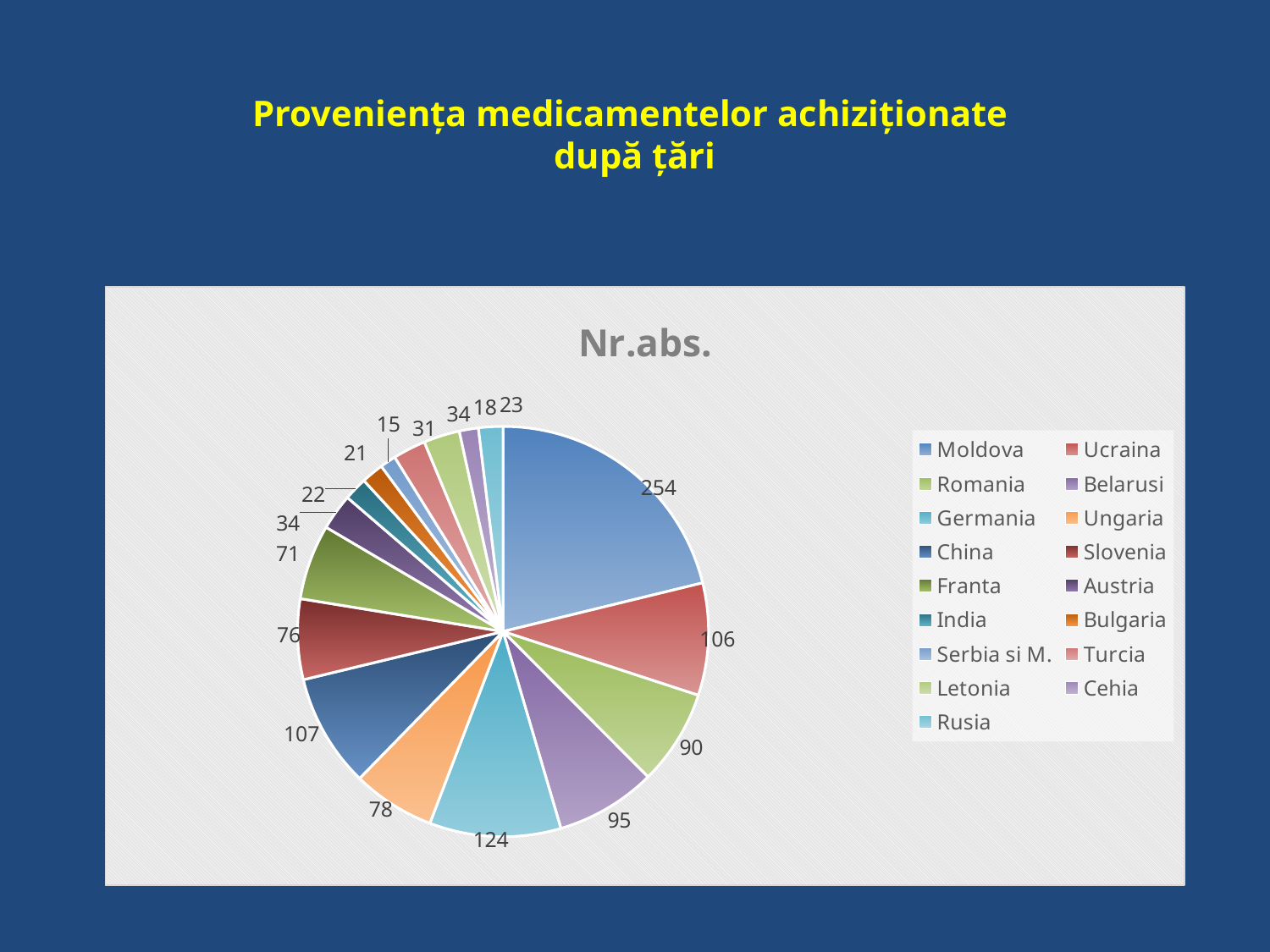
What is the value for Moldova? 254 What kind of chart is shown on the slide? pie chart What is the title shown above the pie chart? Nr.abs. What is the difference between the values for Moldova and Ucraina? 148 What is the value for Ungaria? 78 What is the difference between the values for Germania and Belarusi? 29 Which country has the largest slice? Moldova What is the value for Turcia? 31 How many countries does the legend list? 17 What is the value for Germania? 124 Which is larger, the value for China or the value for Ucraina? China Which country has the smallest slice? Serbia si M.